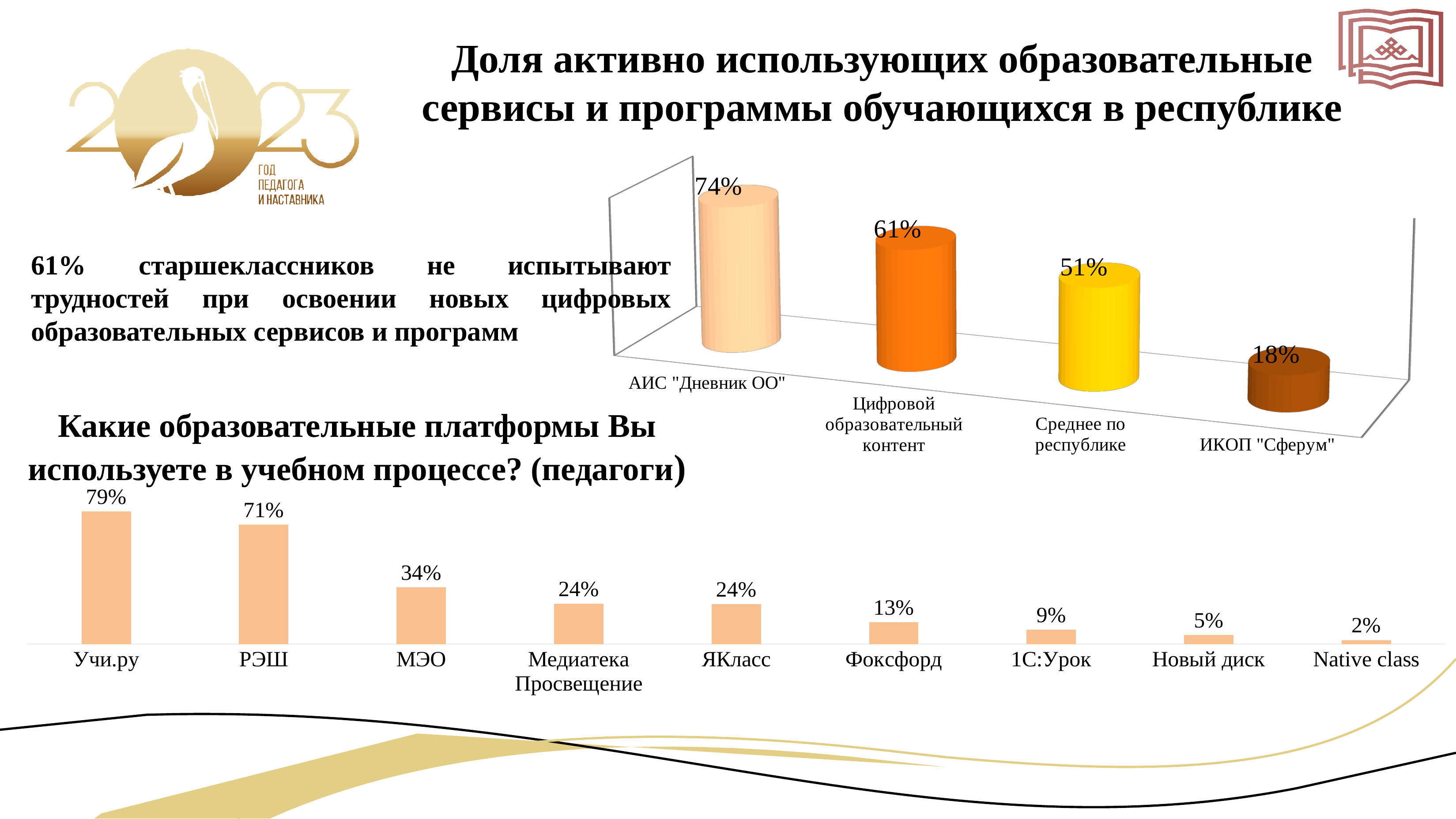
What kind of chart is the bottom chart? bar chart In the bottom chart "Какие образовательные платформы Вы используете в учебном процессе? (педагоги)", what is the value for РЭШ? 71% In the top-right chart, which category has the lowest value? ИКОП "Сферум" In the bottom chart, which platform has the highest value? Учи.ру In the top-right chart, what is the value for ИКОП "Сферум"? 18% How many platforms are shown in the bottom chart? 9 In the top-right chart, what is the difference between Цифровой образовательный контент and Среднее по республике? 10% In the bottom chart, what is the difference between Учи.ру and МЭО? 45% In the top-right chart, what is the value for АИС "Дневник ОО"? 74% In the bottom chart, which platform has the lowest value? Native class In the bottom chart, which is larger: Фоксфорд or 1С:Урок? Фоксфорд How many categories are shown in the top-right chart? 4